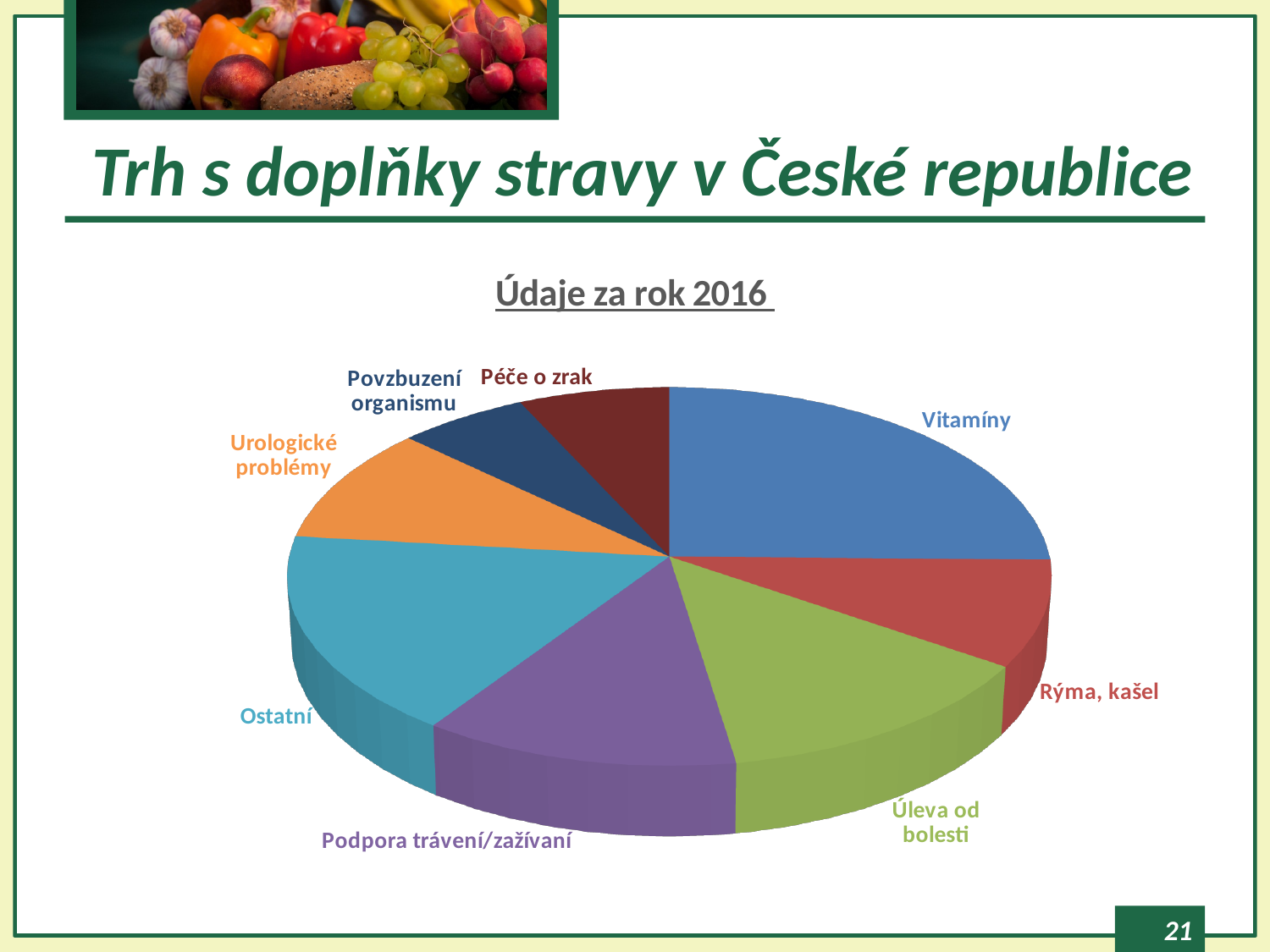
Which slice is larger, Vitamíny or Rýma, kašel? Vitamíny Which category has the largest slice of the pie chart? Vitamíny What colour is the Vitamíny slice? Blue Which slice is larger, Ostatní or Péče o zrak? Ostatní How many categories (slices) does the pie chart have? 8 What is the title shown above the pie chart? Údaje za rok 2016 Which slice is larger, Ostatní or Rýma, kašel? Ostatní What kind of chart is shown on the slide? Pie chart